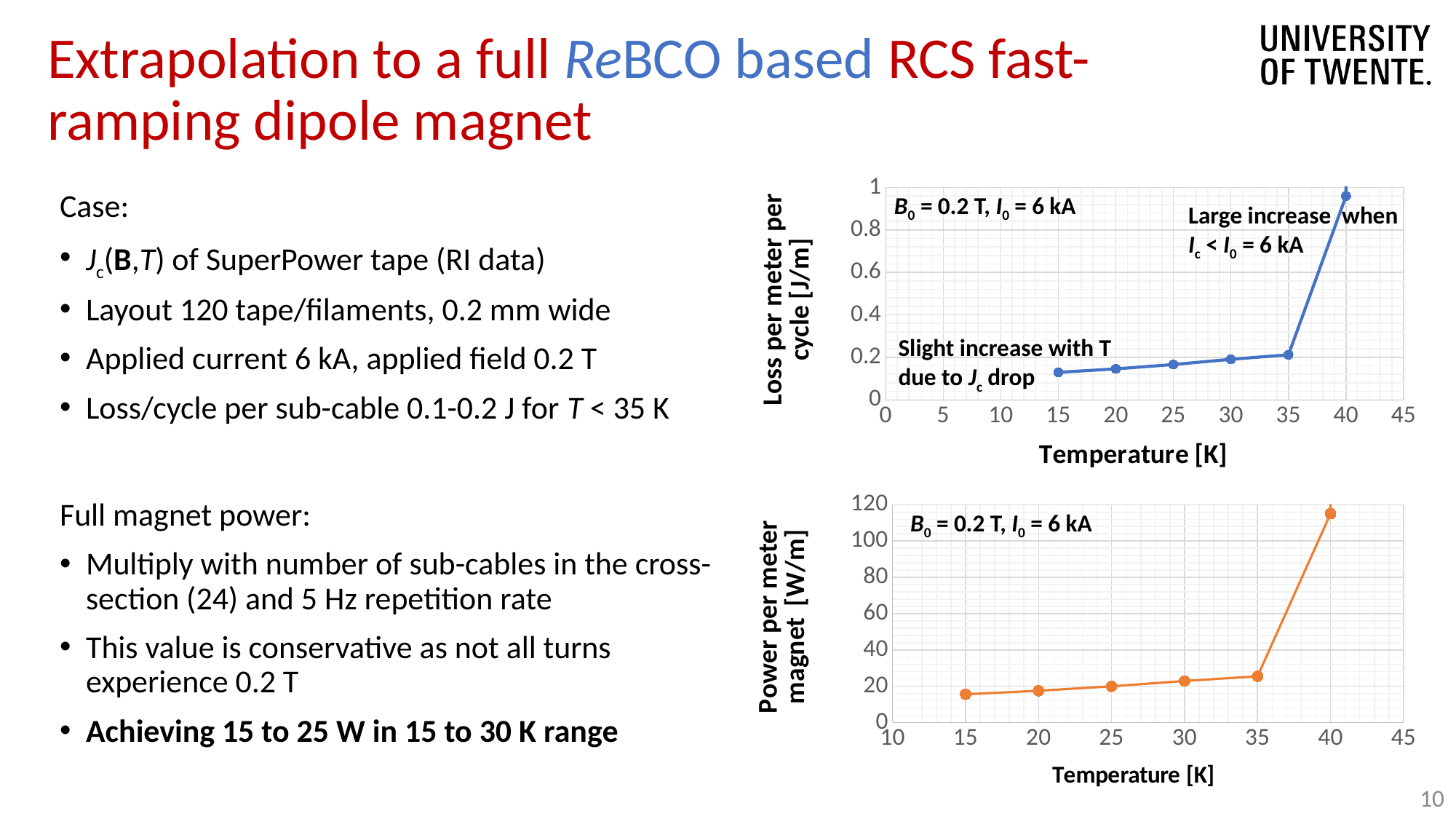
In the bottom chart, how many data points are plotted? 6 In the top chart, how many data points are plotted? 6 In the bottom chart, does the power per meter magnet rise or fall as temperature increases? rise In the bottom chart, is the power per meter magnet at 35 K greater or less than 40 W/m? less In the bottom chart, is the power per meter magnet at 40 K greater or less than 100 W/m? greater In the top chart, which has a higher loss per meter per cycle: 35 K or 40 K? 40 K In the top chart, at which temperature is the loss per meter per cycle highest? 40 K What kind of chart is the bottom chart (Power per meter magnet vs Temperature)? line chart In the bottom chart, at which temperature is the power per meter magnet lowest? 15 K What is the x-axis label of the top chart? Temperature [K] What kind of chart is the top chart (Loss per meter per cycle vs Temperature)? line chart In the top chart, is the loss per meter per cycle at 40 K greater or less than 0.8 J/m? greater